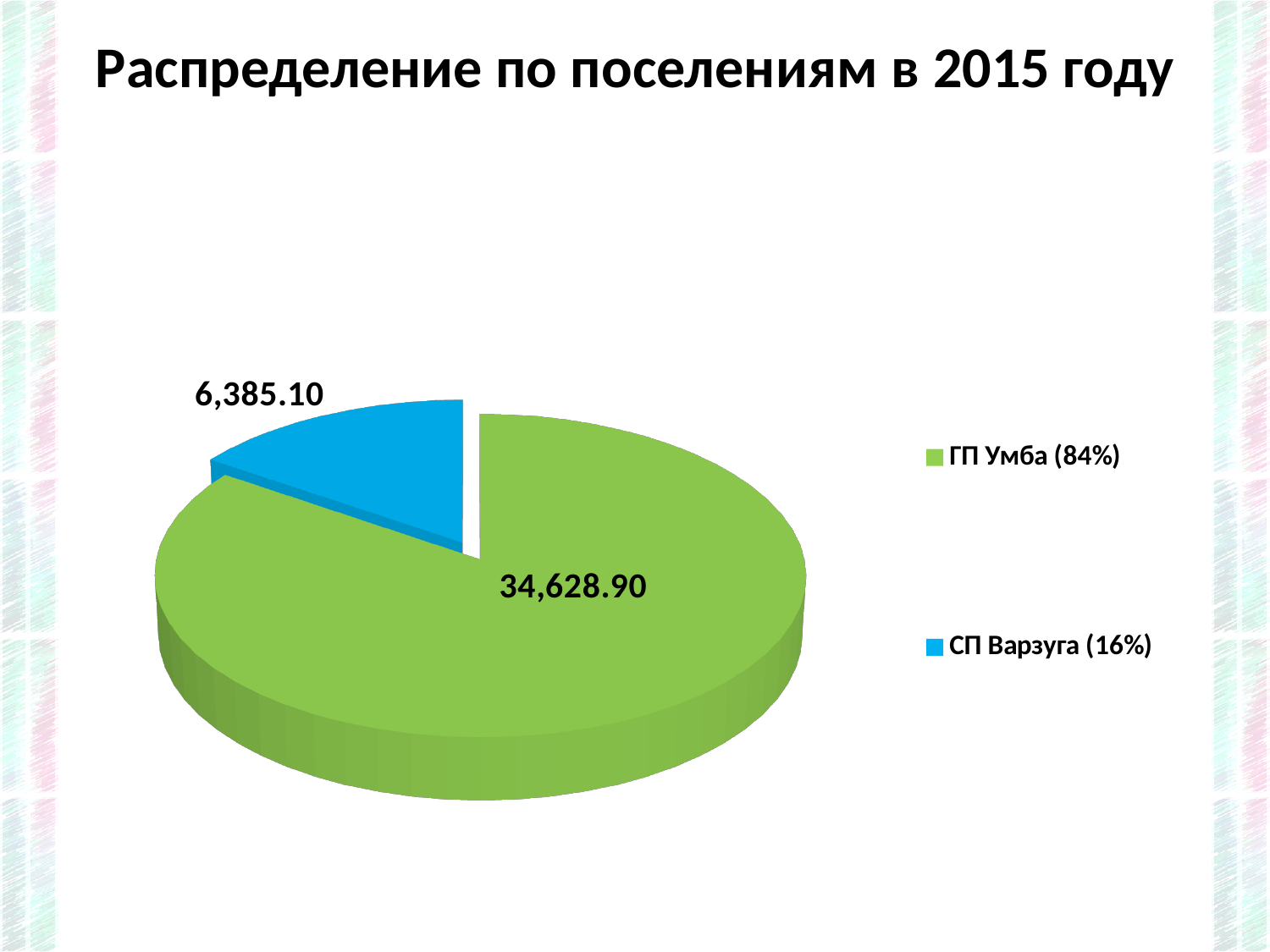
What share of the pie does СП Варзуга represent? 16% How many slices does the pie chart have? 2 What is the title of the slide? Распределение по поселениям в 2015 году Which category has the smallest slice of the pie? СП Варзуга What is the difference between the values for ГП Умба and СП Варзуга? 28,243.80 Which is larger, the value for ГП Умба or the value for СП Варзуга? ГП Умба Which category has the largest slice of the pie? ГП Умба What is the value for ГП Умба? 34,628.90 What is the value for СП Варзуга? 6,385.10 What kind of chart is shown on the slide? Pie chart What share of the pie does ГП Умба represent? 84% What is the total of the two values shown in the pie chart? 41,014.00